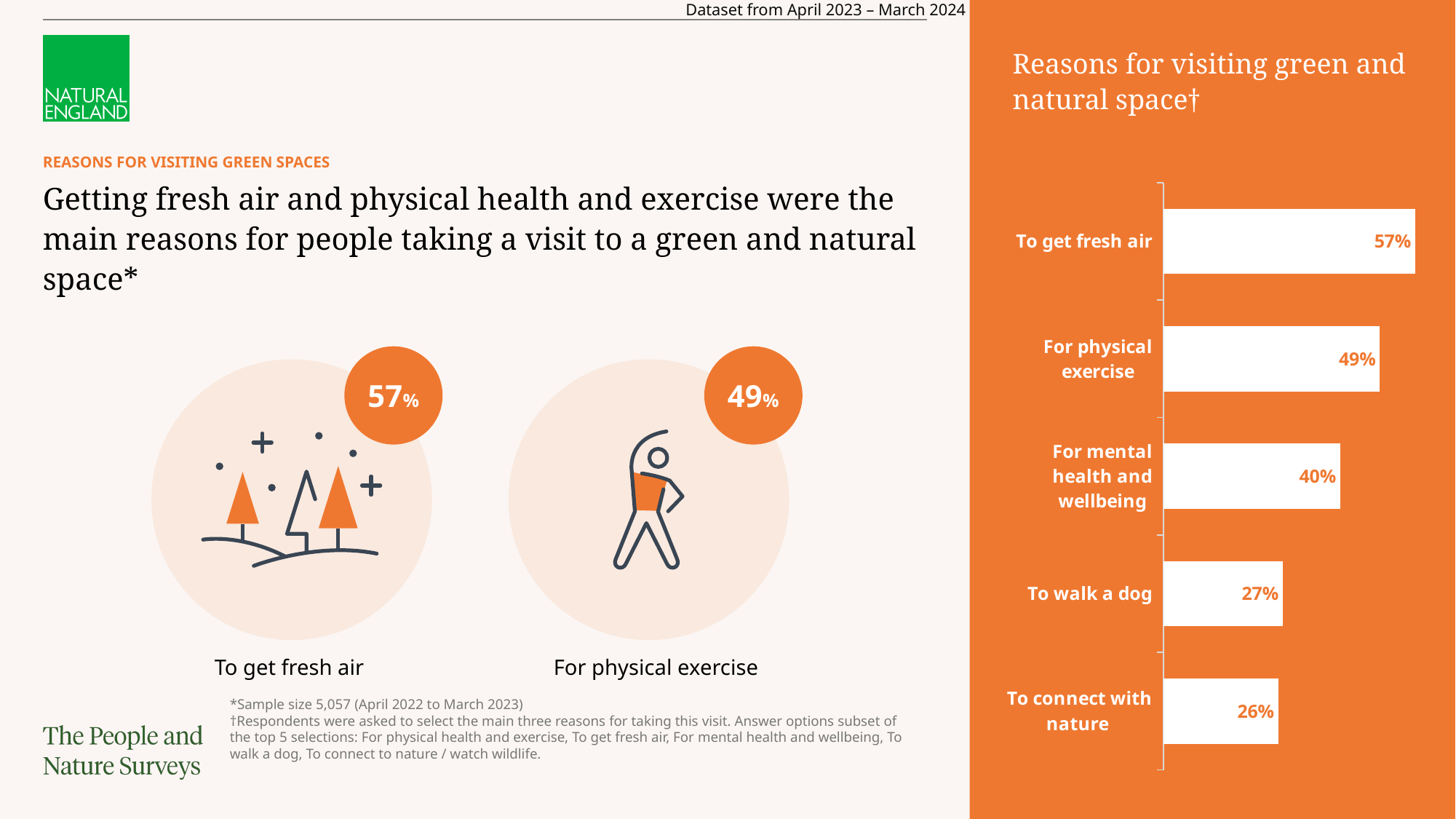
How many reasons are shown in the chart? 5 What kind of chart is shown? Bar chart What is the title of the chart? Reasons for visiting green and natural space† Which reason has the lowest value? To connect with nature Which reason has the highest value? To get fresh air What is the value for 'To get fresh air'? 57% What is the difference between 'For physical exercise' and 'For mental health and wellbeing'? 9% What is the difference between 'To get fresh air' and 'For physical exercise'? 8% What is the value for 'For mental health and wellbeing'? 40% Which is larger, 'For mental health and wellbeing' or 'To walk a dog'? For mental health and wellbeing What is the value for 'To connect with nature'? 26% What is the value for 'To walk a dog'? 27%